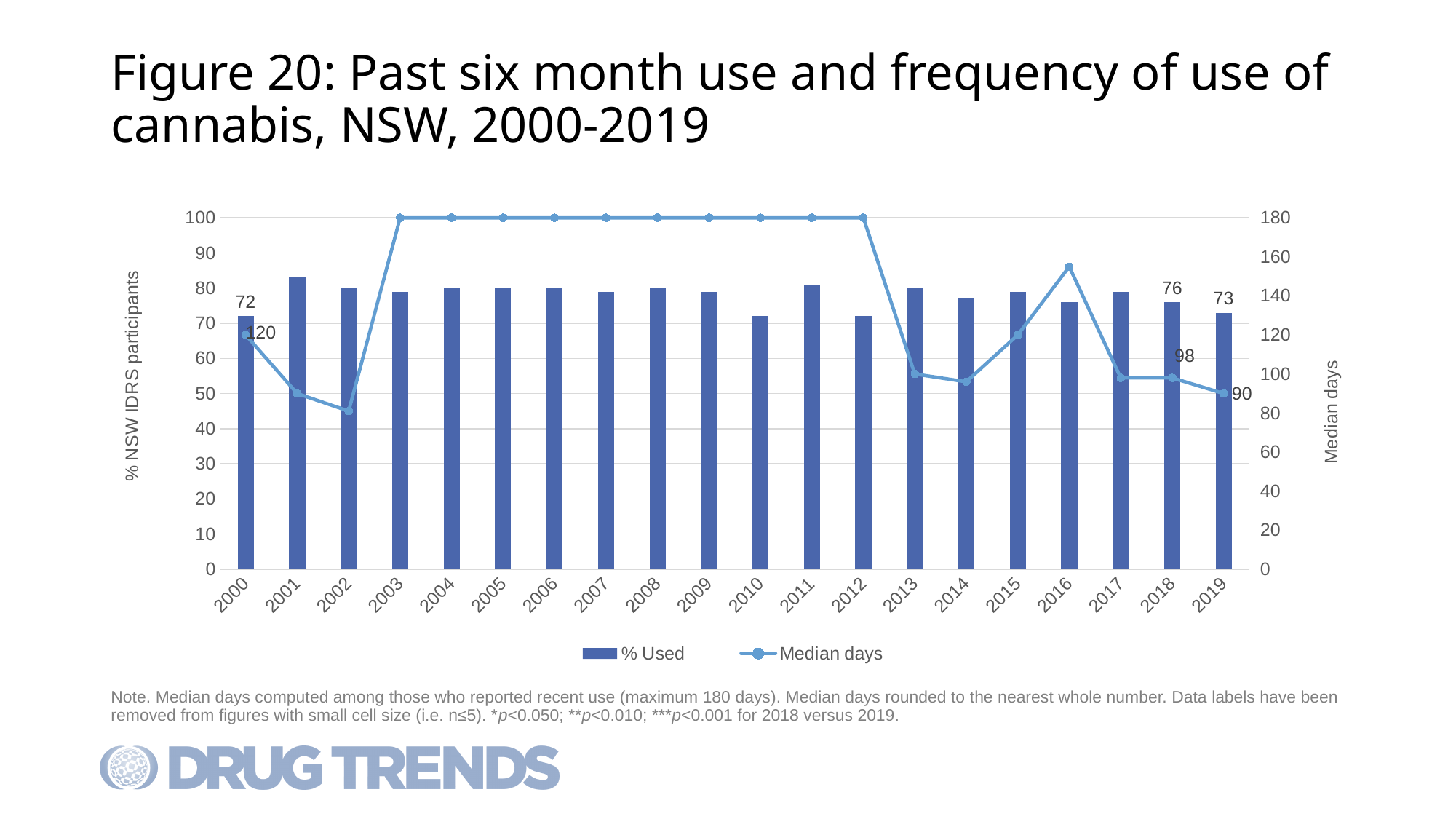
What is the % Used value for 2000? 72 What is the difference between the % Used values for 2018 and 2019? 3 What is the Median days value for 2005? 180 Which year has the larger Median days value, 2018 or 2019? 2018 What is the difference between the Median days values for 2000 and 2019? 30 Is the Median days value for 2016 greater or less than 140? greater How many series does the legend list? 2 What is the Median days value for 2018? 98 Is the % Used value for 2001 greater or less than 80? greater What is the % Used value for 2019? 73 What is the Median days value for 2000? 120 How many years are shown on the x axis? 20